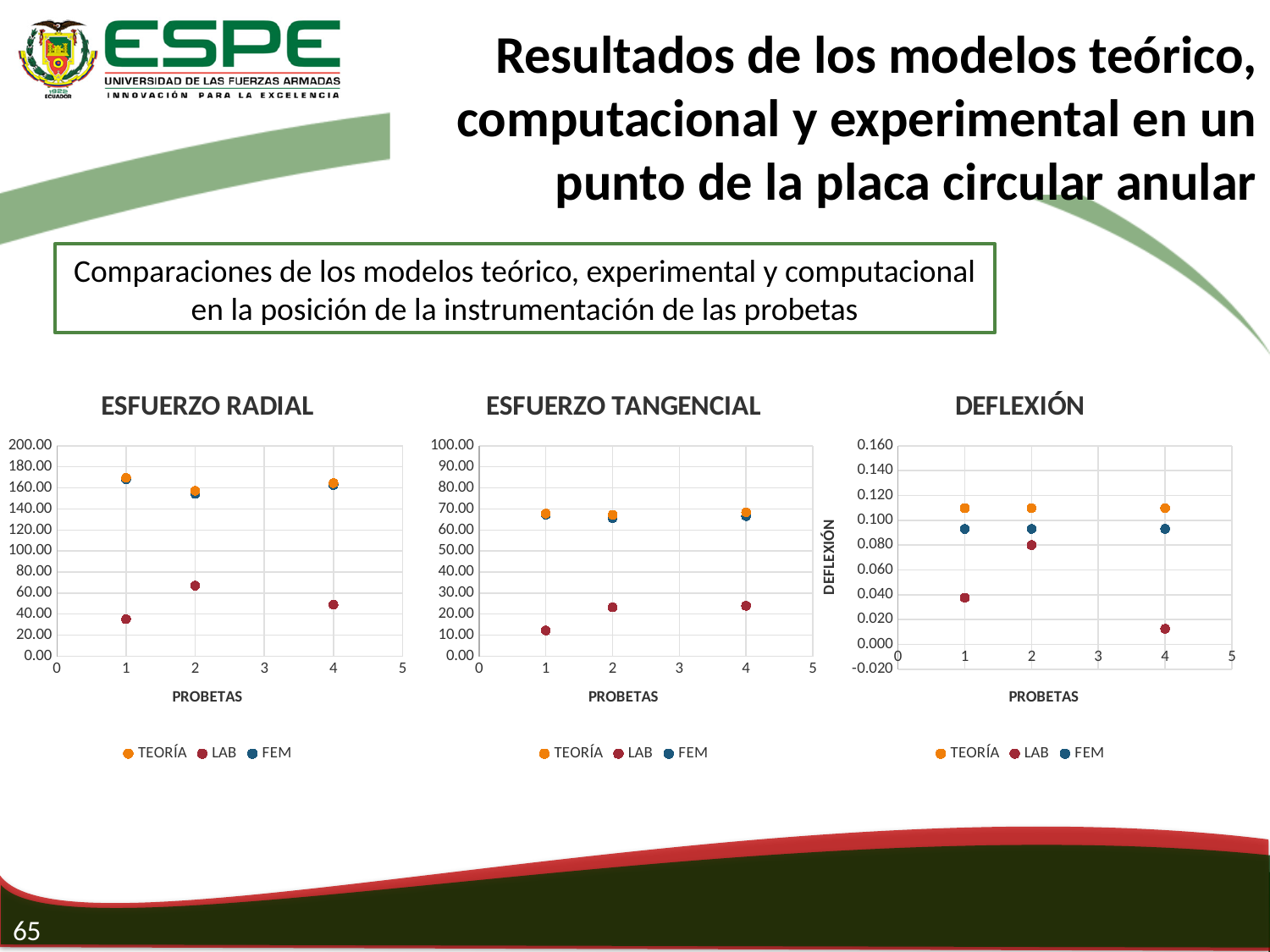
What is the x-axis title of the ESFUERZO TANGENCIAL chart? PROBETAS In the ESFUERZO RADIAL chart, is the TEORÍA value at probeta 1 greater or less than 140.00? greater In the ESFUERZO TANGENCIAL chart, is the LAB value at probeta 1 greater or less than 20.00? less In the DEFLEXIÓN chart, at which probeta is the LAB value lowest? Probeta 4 What kind of chart is the ESFUERZO RADIAL chart? Scatter chart How many series does the legend of the ESFUERZO TANGENCIAL chart list? 3 In the ESFUERZO TANGENCIAL chart, at which probeta is the LAB value lowest? Probeta 1 In the DEFLEXIÓN chart, is the LAB value at probeta 4 greater or less than 0.020? less In the DEFLEXIÓN chart, at how many probeta positions are points plotted? 3 In the ESFUERZO RADIAL chart, at which probeta is the LAB value highest? Probeta 2 In the DEFLEXIÓN chart, which is larger at probeta 1, the TEORÍA value or the FEM value? TEORÍA